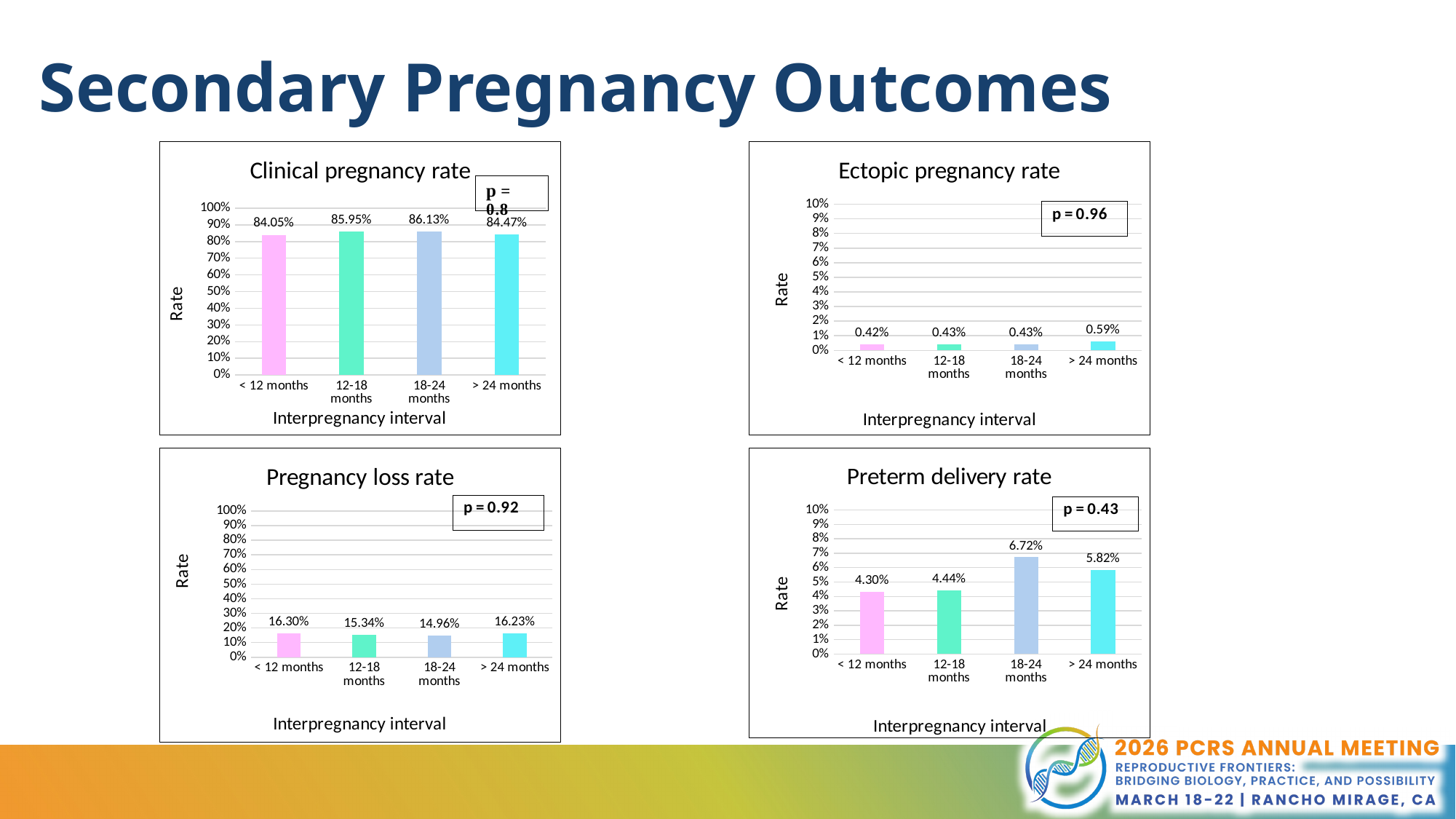
What kind of chart is the Ectopic pregnancy rate chart? Bar chart In the Pregnancy loss rate chart, what is the value for 12-18 months? 15.34% In the Ectopic pregnancy rate chart, which interpregnancy interval has the highest rate? > 24 months How many interpregnancy interval categories are shown in the Pregnancy loss rate chart? 4 In the Clinical pregnancy rate chart, which interpregnancy interval has the lowest rate? < 12 months In the Preterm delivery rate chart, which interpregnancy interval has the highest rate? 18-24 months In the Preterm delivery rate chart, which is larger: the value for > 24 months or the value for 12-18 months? > 24 months In the Preterm delivery rate chart, what is the value for 18-24 months? 6.72% In the Preterm delivery rate chart, what is the difference between the 18-24 months value and the < 12 months value? 2.42% In the Clinical pregnancy rate chart, what is the value for 18-24 months? 86.13% In the Pregnancy loss rate chart, which interpregnancy interval has the lowest rate? 18-24 months In the Ectopic pregnancy rate chart, what is the value for > 24 months? 0.59%